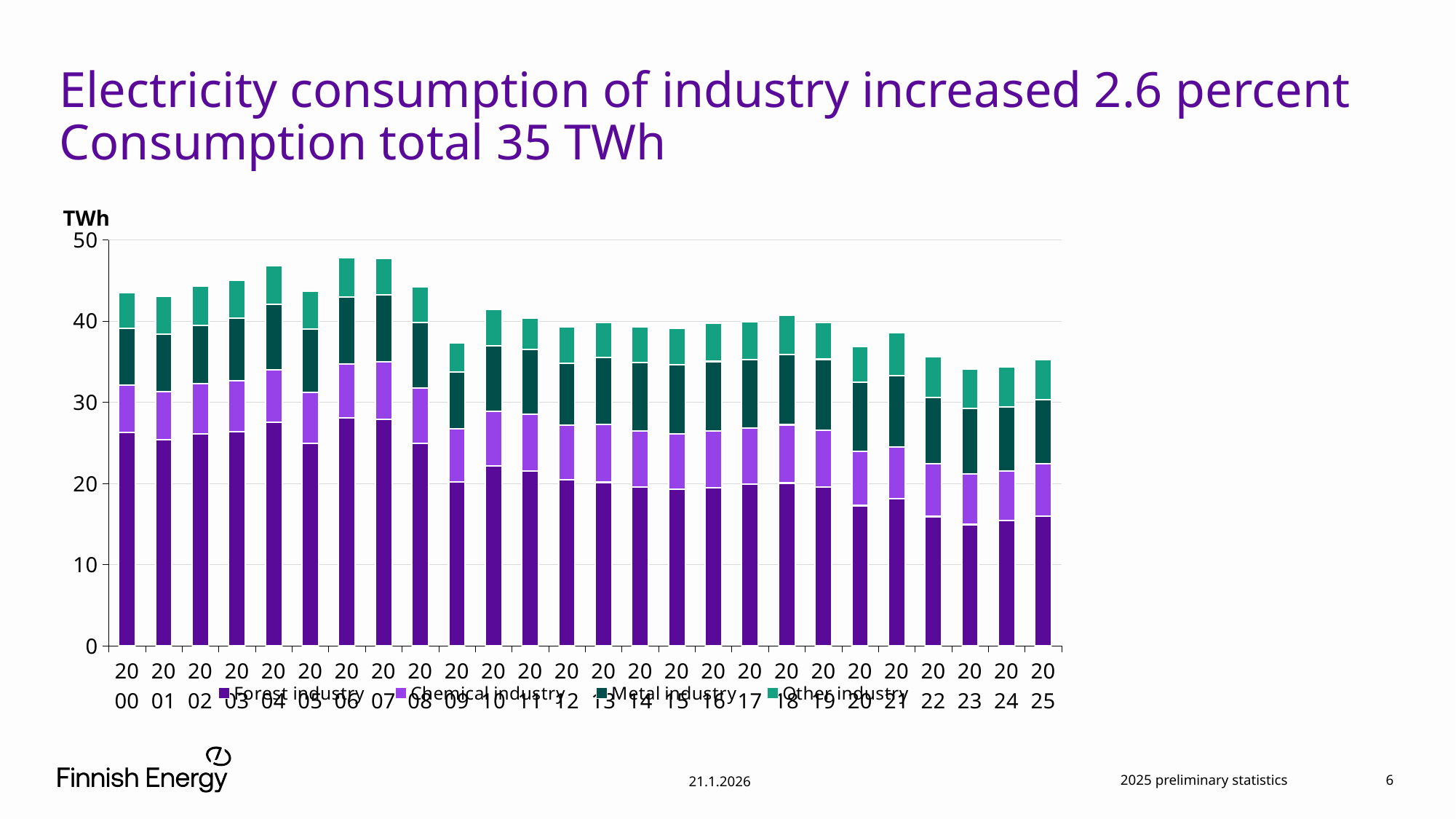
Is the Forest industry segment for 2025 greater or less than 20 TWh? less How many series does the legend list? 4 Is the Forest industry segment for 2000 greater or less than 20 TWh? greater What unit is shown on the vertical axis? TWh What kind of chart is shown on the slide? Stacked bar chart Do the total bars rise or fall from 2007 to 2009? fall Is the total bar for 2000 greater or less than 40 TWh? greater Which year has the larger total bar, 2007 or 2009? 2007 How many years (bars) are plotted on the chart? 26 Which industries are listed in the legend? Forest industry, Chemical industry, Metal industry, Other industry